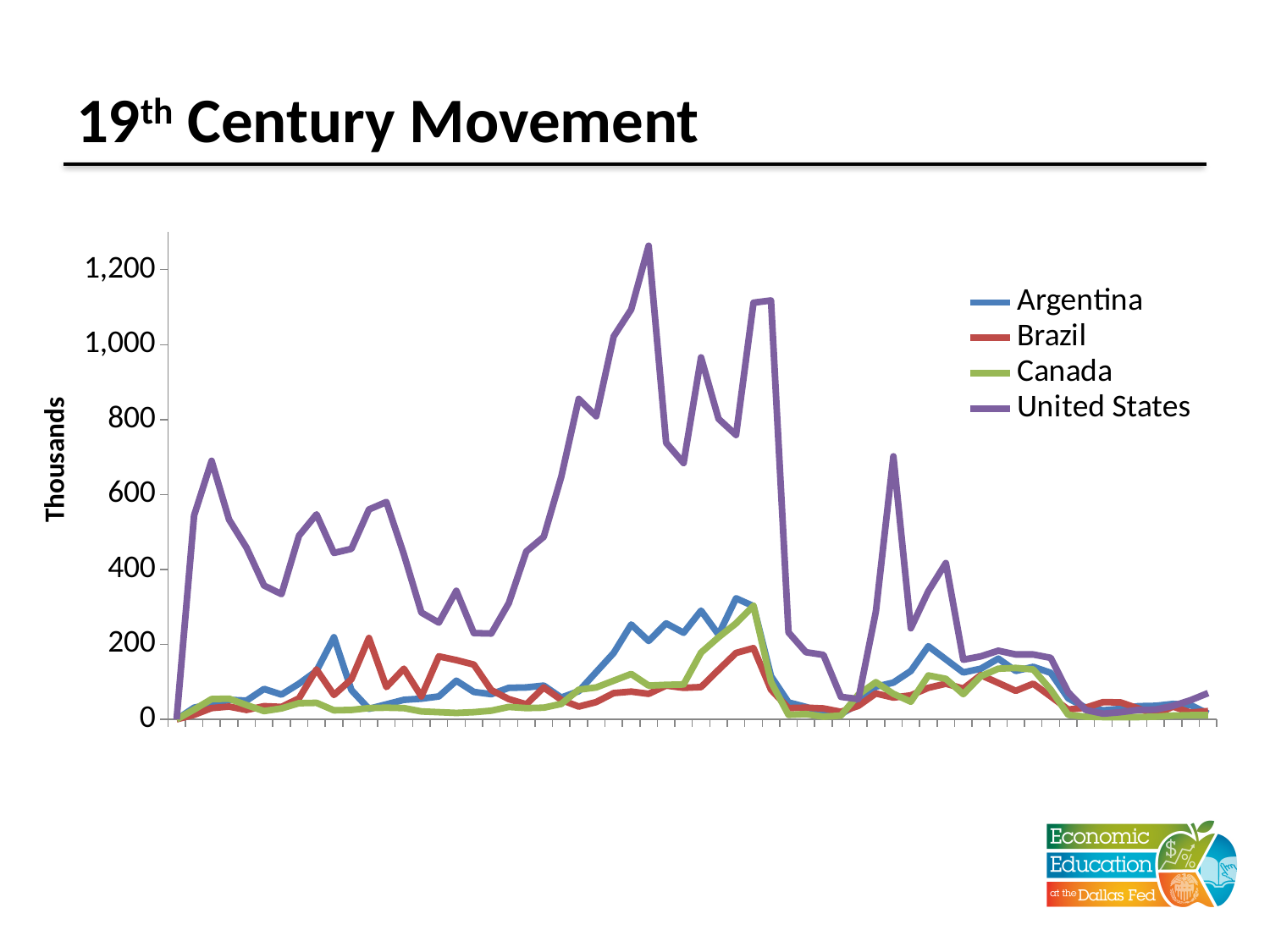
What colour is the United States line? purple Is the highest value of the Brazil line greater or less than 400? less Which series has the lowest peak value on the chart? Brazil How many series does the legend list? 4 Is the highest value of the United States line greater or less than 1,200? greater What kind of chart is shown on the slide? line chart Is the highest value of the Canada line greater or less than 200? greater Which series has a higher peak value, United States or Argentina? United States Which series reaches the highest value on the chart? United States What is the highest tick value shown on the vertical axis? 1,200 What is the label on the vertical axis? Thousands